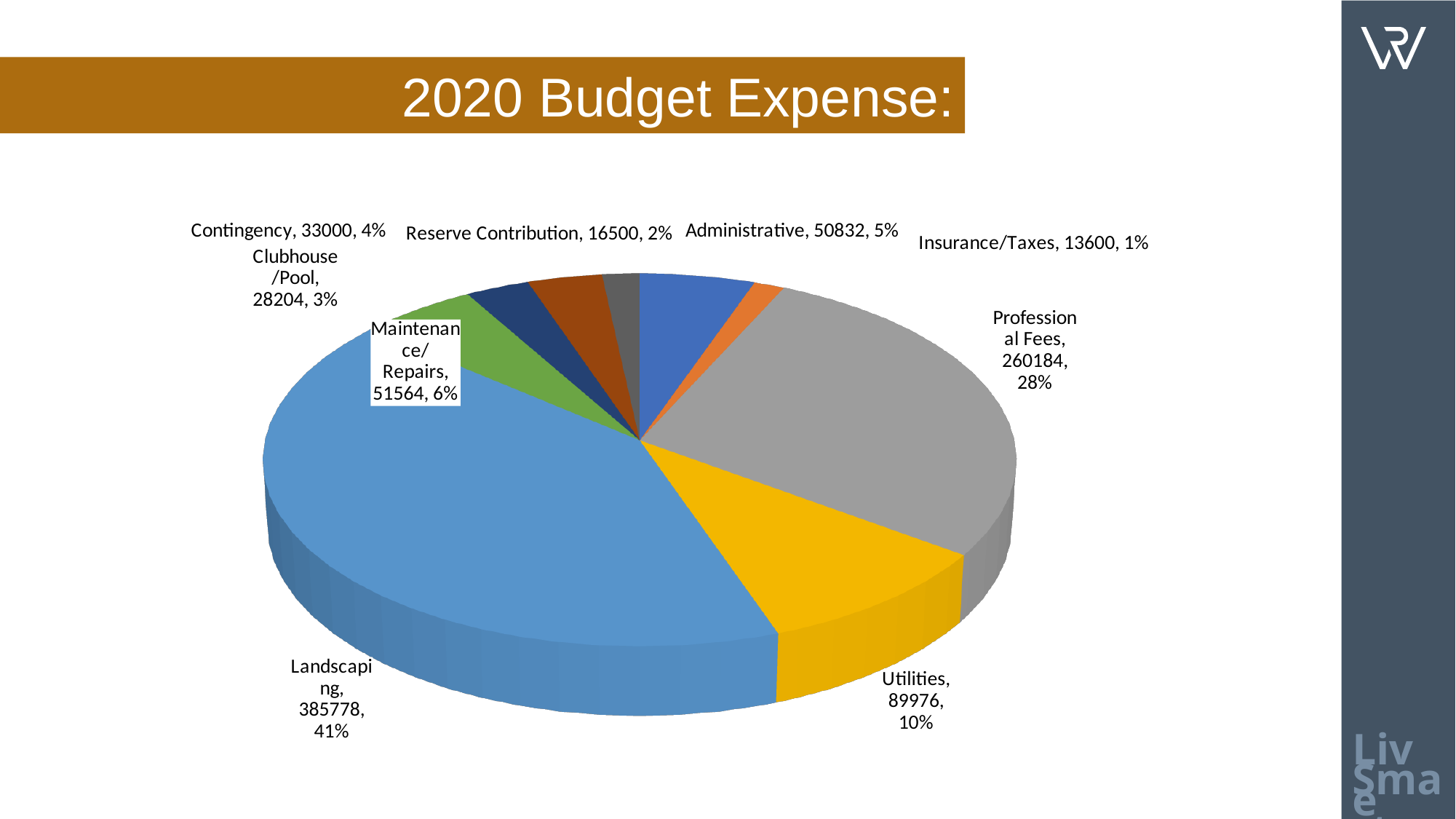
How many categories are shown in the pie chart? 9 What is the value for Professional Fees? 260184 Which category has the largest slice of the pie? Landscaping What share of the pie does Maintenance/Repairs represent? 6% What is the value for Landscaping? 385778 What kind of chart is shown on the slide? Pie chart What is the value for Reserve Contribution? 16500 What is the value for Utilities? 89976 Which category has the smallest slice of the pie? Insurance/Taxes What is the difference between the values for Landscaping and Professional Fees? 125594 What share of the pie does Professional Fees represent? 28% Which is larger, the value for Contingency or the value for Clubhouse/Pool? Contingency